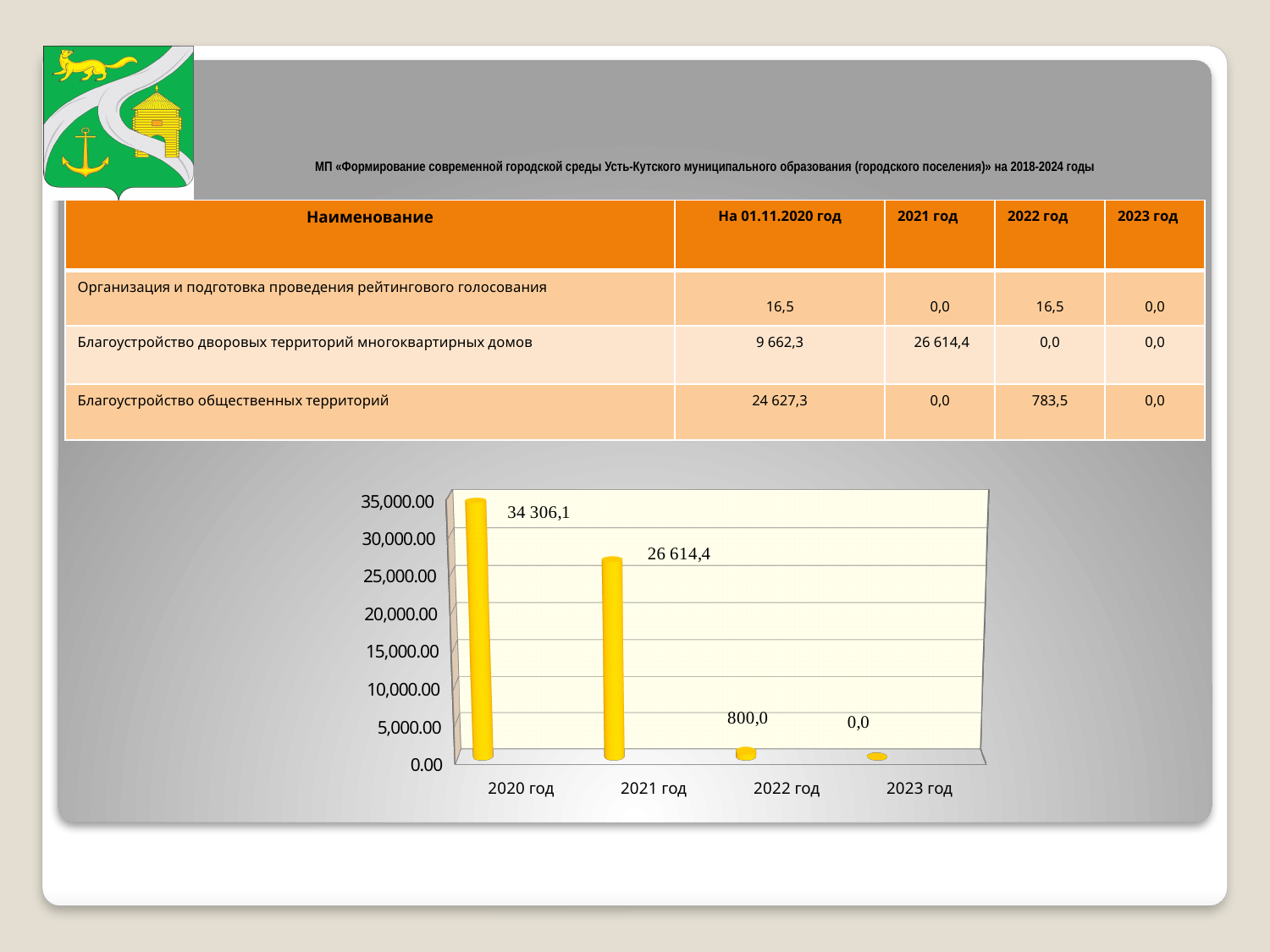
What is the difference between the values for 2020 год and 2021 год in the chart? 7 691,7 What is the value shown for 2021 год in the chart? 26 614,4 Is the value for 2021 год in the chart greater or less than 25,000.00? greater Which is larger in the chart, the value for 2021 год or the value for 2022 год? 2021 год What kind of chart is shown on the slide? bar chart How many years are shown on the x axis of the chart? 4 Which year has the lowest value in the chart? 2023 год What is the value shown for 2020 год in the chart? 34 306,1 Do the values in the chart rise or fall from 2020 год to 2023 год? fall What is the value shown for 2022 год in the chart? 800,0 Which year has the highest value in the chart? 2020 год What is the value shown for 2023 год in the chart? 0,0